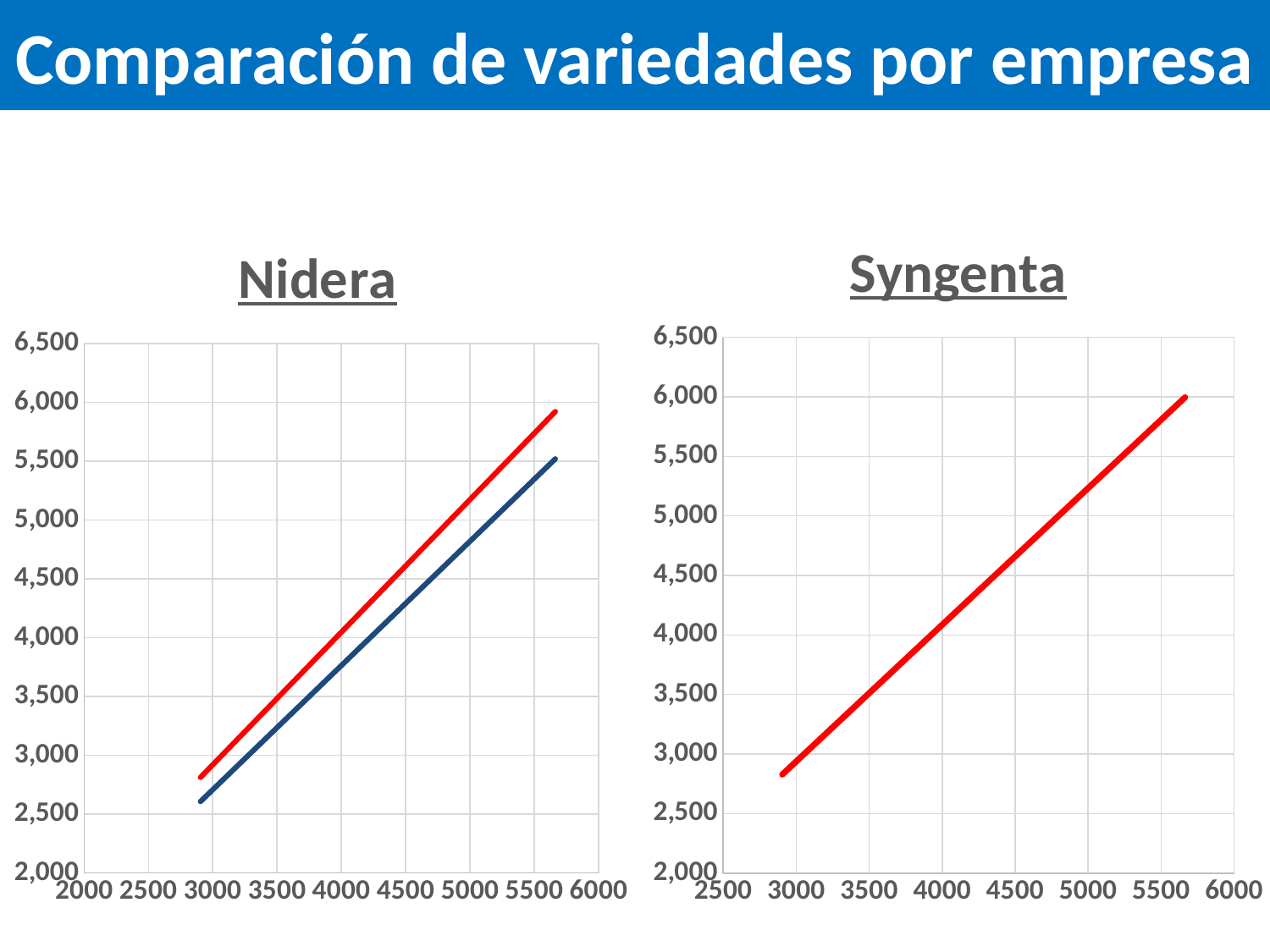
On the Nidera chart, is the value of the red line at x = 5500 greater or less than 5,500? greater On the Nidera chart, which line is higher, the red line or the blue line? red line What kind of chart is the Nidera chart? line chart On the Syngenta chart, does the line rise or fall as the x-axis value increases? rise How many lines are plotted on the Nidera chart? 2 On the Syngenta chart, is the value of the line at x = 3000 greater or less than 3,500? less On the Nidera chart, do the lines rise or fall as the x-axis value increases? rise What is the title of the chart on the left side of the slide? Nidera On the Nidera chart, is the value of the blue line at x = 3000 greater or less than 3,000? less How many lines are plotted on the Syngenta chart? 1 What kind of chart is the Syngenta chart? line chart